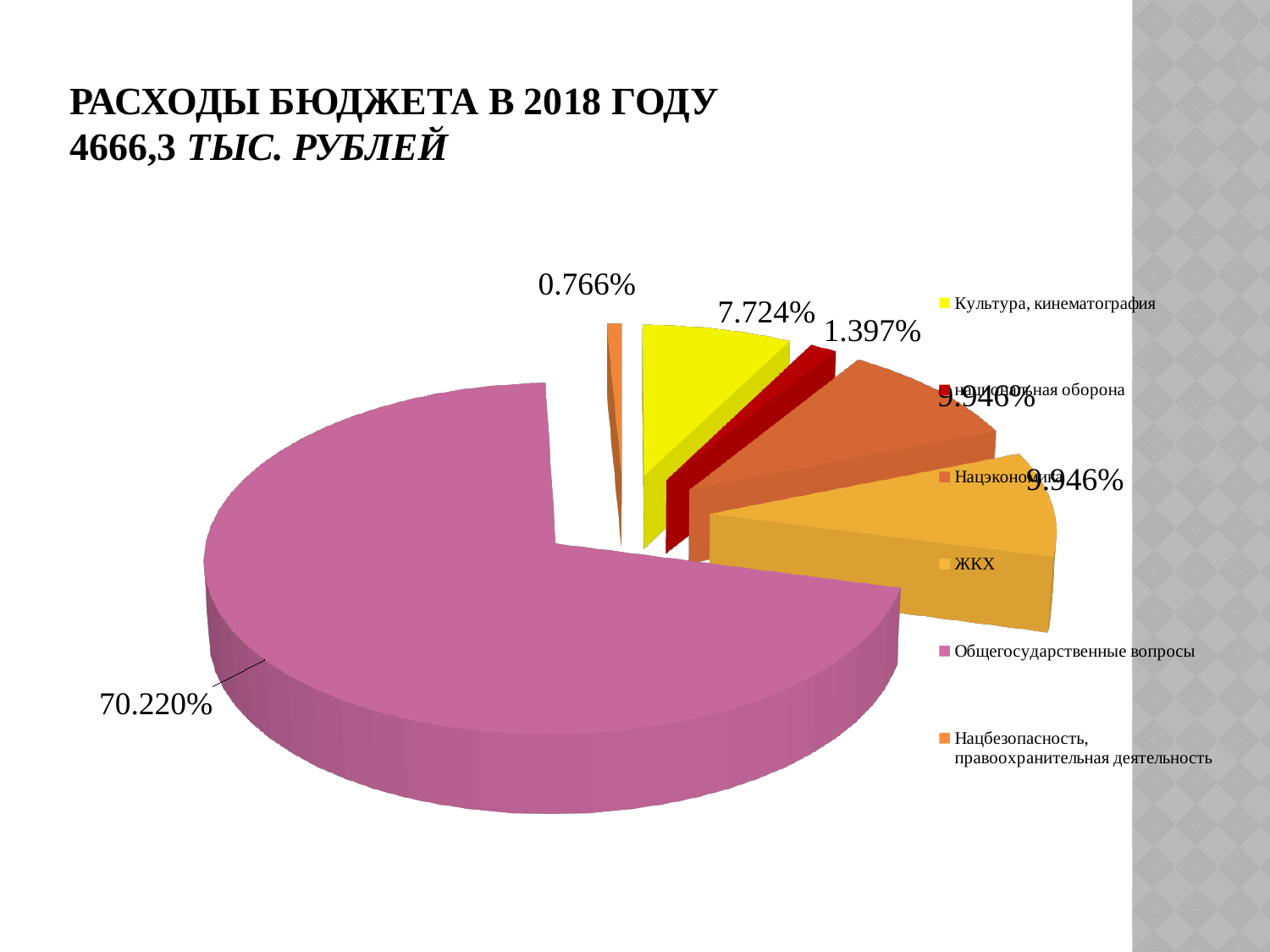
What share of the pie is labelled for национальная оборона? 1.397% What share of the pie is labelled for Общегосударственные вопросы? 70.220% What share of the pie is labelled for Культура, кинематография? 7.724% What colour is the slice for Общегосударственные вопросы? pink What is the difference between the share for Общегосударственные вопросы and the share for Культура, кинематография? 62.496% Which is larger: the share for Культура, кинематография or the share for национальная оборона? Культура, кинематография Which category has the smallest share of the pie? Нацбезопасность, правоохранительная деятельность How many categories does the legend of the pie chart list? 6 What kind of chart is shown on the slide? pie chart Which category has the largest share of the pie? Общегосударственные вопросы What total amount in thousand rubles is stated in the slide title for budget expenditures in 2018? 4666,3 тыс. рублей